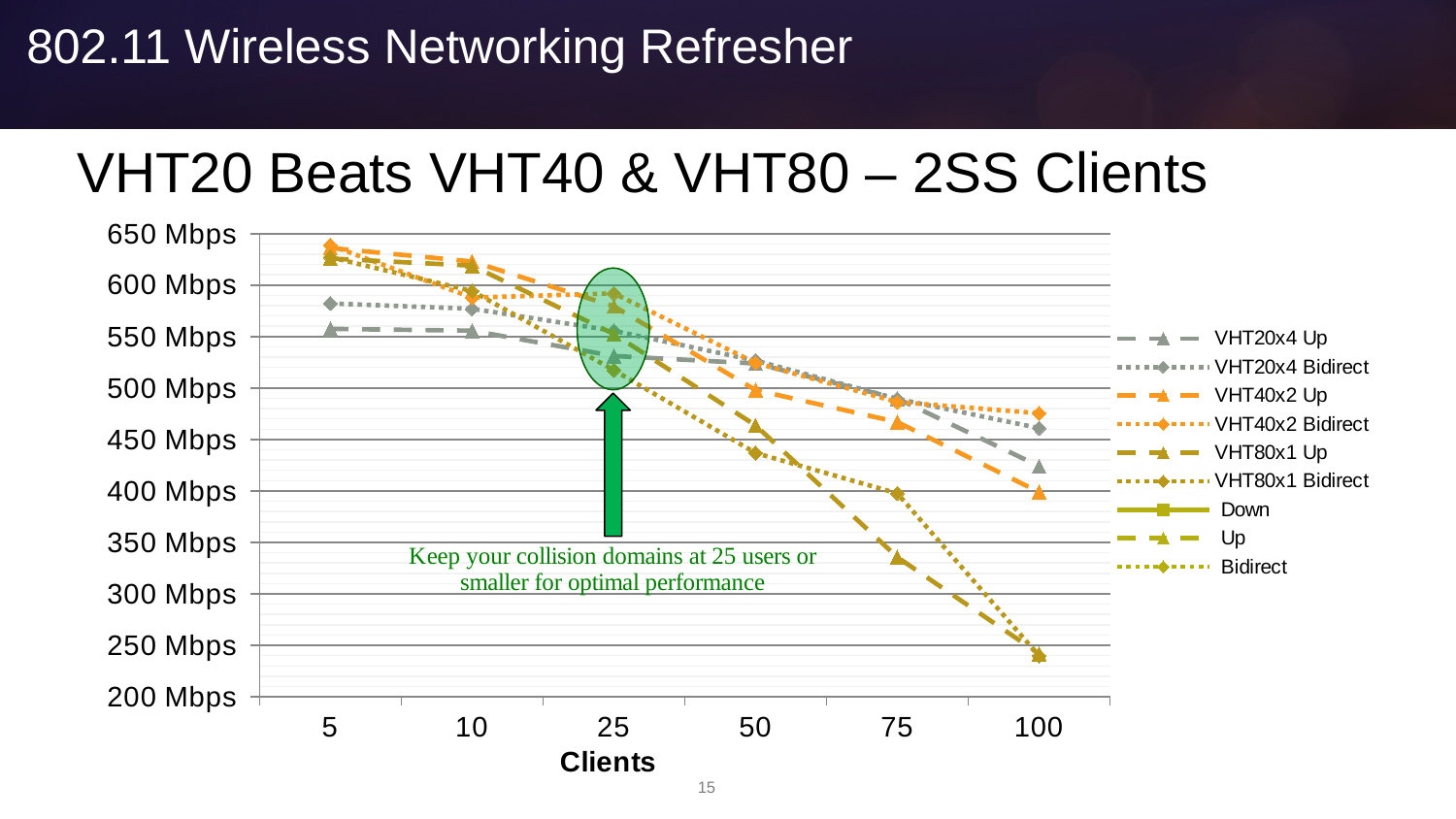
Is the value for VHT80x1 Up at 100 clients greater or less than 300 Mbps? less How many entries does the chart legend list? 9 Does the VHT80x1 Up series rise or fall as the number of clients increases? fall Is the value for VHT80x1 Up at 75 clients greater or less than 350 Mbps? less Is the value for VHT40x2 Bidirect at 5 clients greater or less than 600 Mbps? greater Which series has the lowest value at 75 clients? VHT80x1 Up At 100 clients, which is larger: VHT40x2 Bidirect or VHT80x1 Up? VHT40x2 Bidirect What is the highest value shown on the y axis? 650 Mbps How many client counts are plotted along the x axis? 6 What is the title of the x axis? Clients What kind of chart is shown on the slide? line chart